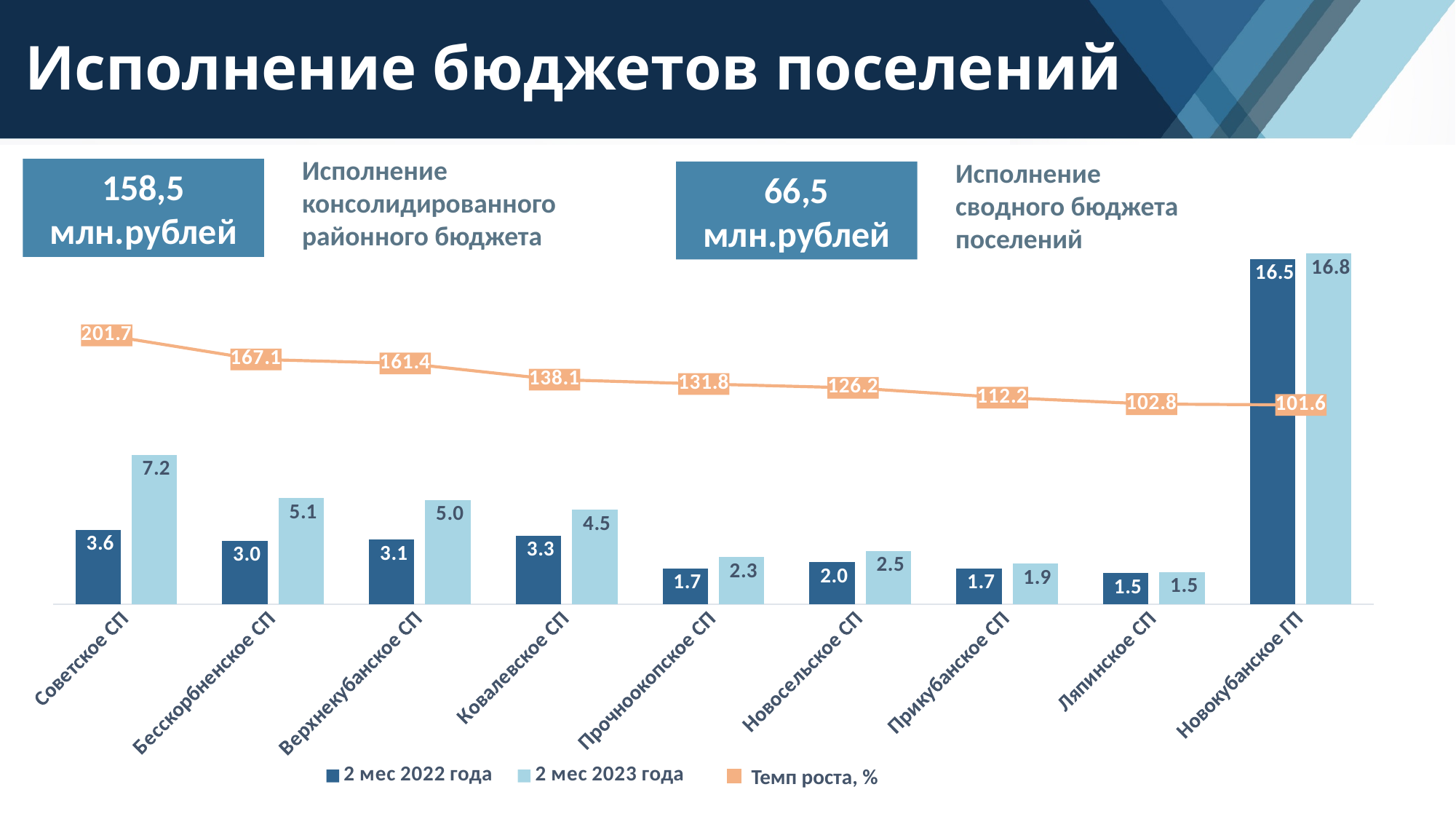
What is the value for Советское СП in the 2 мес 2023 года series? 7.2 What is the value for Ляпинское СП in the 2 мес 2022 года series? 1.5 What is the difference between the 2 мес 2023 года and 2 мес 2022 года values for Советское СП? 3.6 Which category has the highest value in the 2 мес 2023 года series? Новокубанское ГП How many series does the legend list? 3 How many categories are shown on the x axis of the chart? 9 Which is larger for Прочноокопское СП: the 2 мес 2022 года value or the 2 мес 2023 года value? 2 мес 2023 года What kind of chart is shown on the slide? Combined bar and line chart What is the value for Ковалевское СП in the 2 мес 2022 года series? 3.3 What is the Темп роста, % value for Бесскорбненское СП? 167.1 Does the Темп роста, % line rise or fall from left to right along the x axis? Fall Which category has the lowest Темп роста, % value? Новокубанское ГП